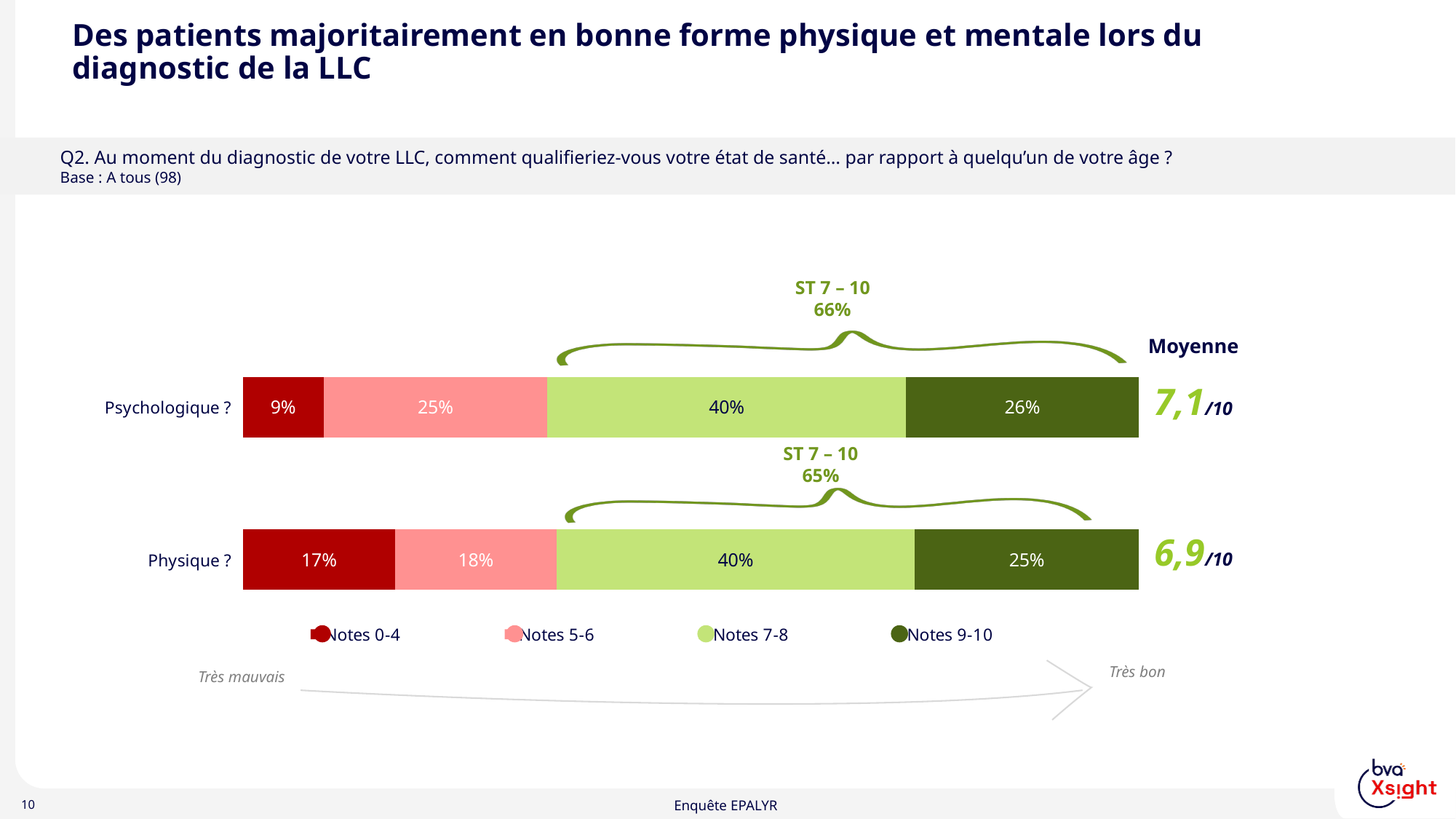
What is the ST 7 – 10 value shown for Psychologique ? 66% What is the average (Moyenne) score shown for Physique ? 6,9/10 What is the value for Notes 5-6 in the Physique ? bar? 18% Which segment is the largest in the Physique ? bar? Notes 7-8 What is the value for Notes 9-10 in the Psychologique ? bar? 26% Which segment is the smallest in the Psychologique ? bar? Notes 0-4 Which is larger: the Notes 5-6 value for Psychologique ? or for Physique ? Psychologique ? What is the difference between the Notes 0-4 values for Physique ? and Psychologique ? 8 percentage points What percentage of respondents gave a score of 0-4 for their psychological health? 9% What percentage of respondents gave a score of 0-4 for their physical health? 17% What kind of chart is shown on the slide? Stacked bar chart How many series does the legend list? 4